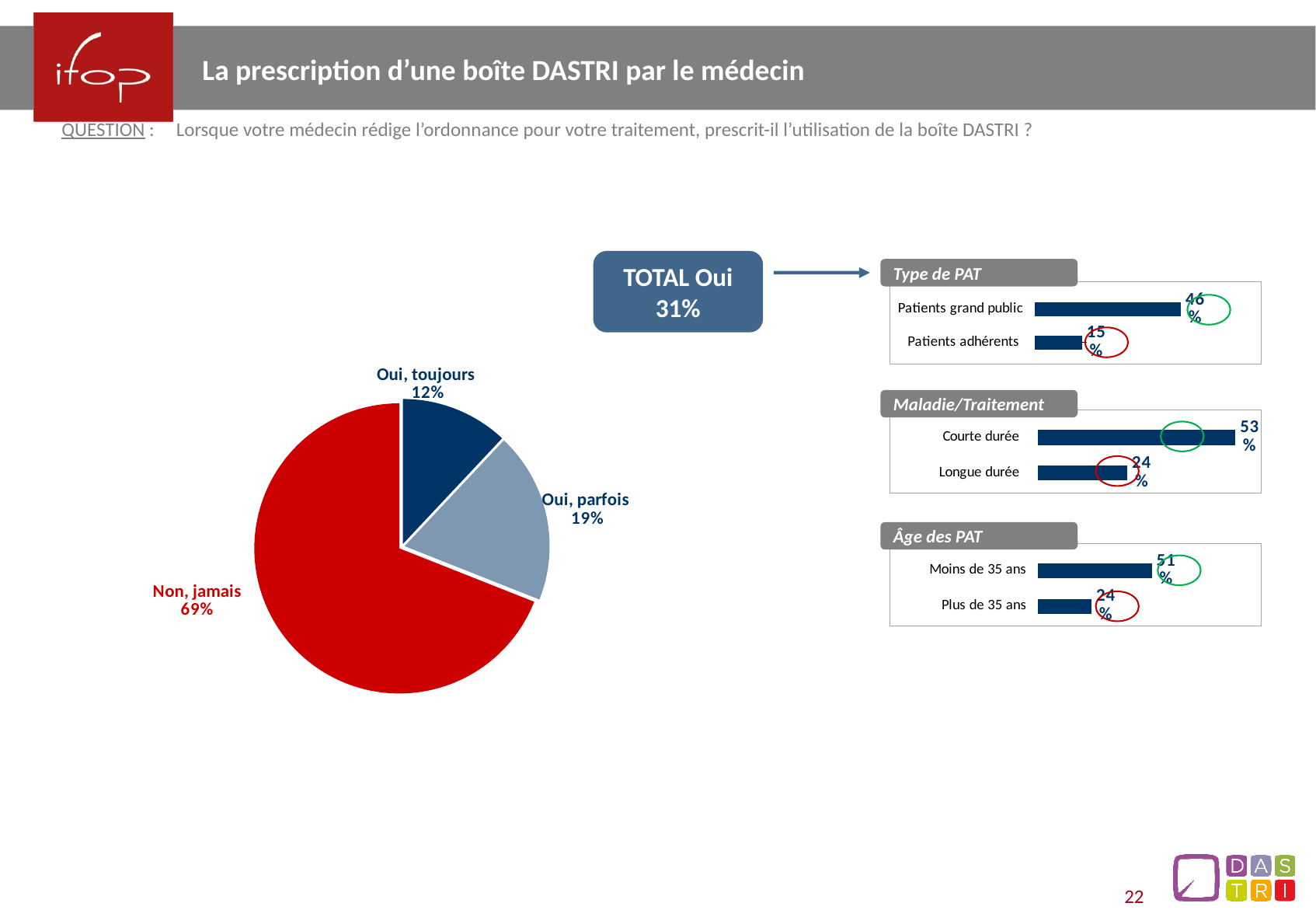
In the pie chart, which category has the largest slice? Non, jamais In the "Âge des PAT" bar chart, which is larger, "Moins de 35 ans" or "Plus de 35 ans"? Moins de 35 ans What kind of chart is used in the "Âge des PAT" panel? Bar chart In the pie chart, what is the difference between the "Oui, parfois" and "Oui, toujours" shares? 7% In the "Type de PAT" bar chart, which category has the lower value? Patients adhérents In the pie chart, what share is labelled for "Oui, parfois"? 19% What kind of chart is the large chart on the left of the slide? Pie chart In the "Type de PAT" bar chart, what is the value for "Patients grand public"? 46% In the pie chart, which category has the smallest slice? Oui, toujours In the "Maladie/Traitement" bar chart, what is the difference between "Courte durée" and "Longue durée"? 29% How many slices does the pie chart have? 3 In the pie chart, what share is labelled for "Non, jamais"? 69%